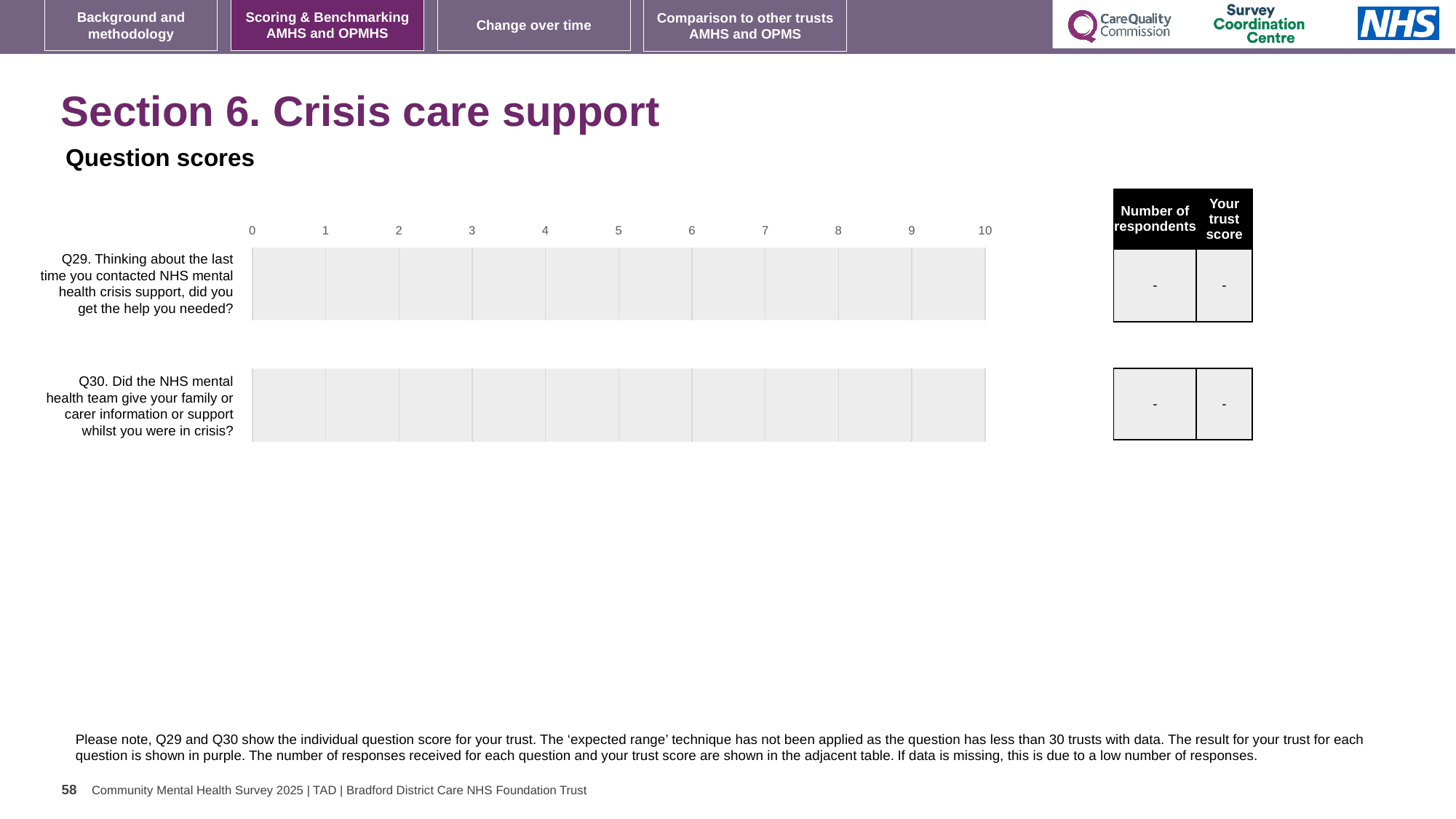
How many questions are listed as categories on the chart? 2 What is the lowest value shown on the chart's x axis? 0 What is the highest value shown on the chart's x axis? 10 What is shown in the 'Your trust score' column for Q30? - What kind of chart is used for the question scores? bar chart What is shown in the 'Your trust score' column for Q29? - What is shown in the 'Number of respondents' column for Q30? - What is shown in the 'Number of respondents' column for Q29? -